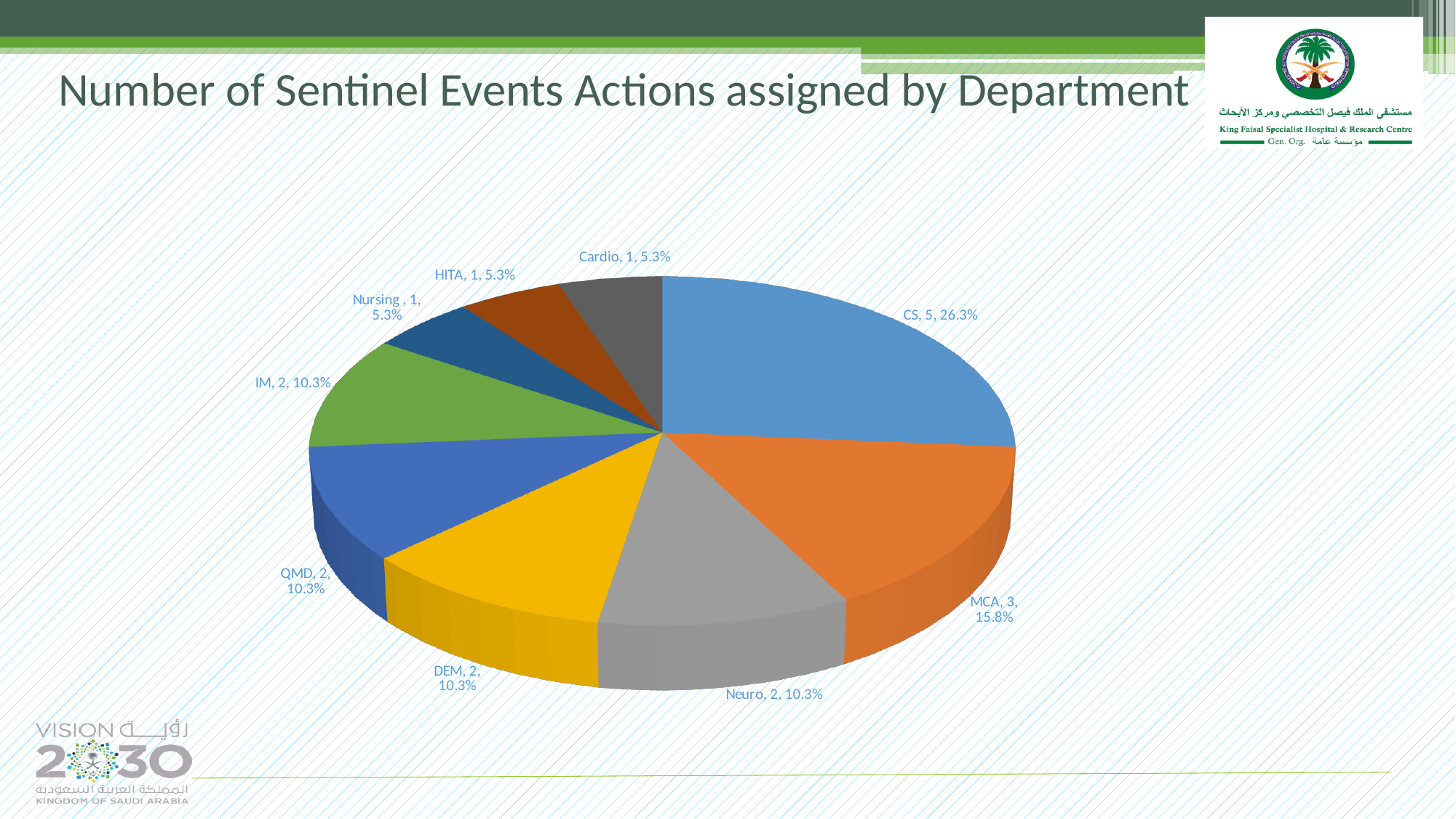
What is the total number of sentinel event actions across all departments in the pie chart? 19 Which department has the highest number of sentinel event actions? CS How many sentinel event actions are assigned to Cardio? 1 What is the title of the chart on the slide? Number of Sentinel Events Actions assigned by Department How many sentinel event actions are assigned to MCA? 3 Which has more sentinel event actions, MCA or IM? MCA How many sentinel event actions are assigned to CS? 5 How many departments (slices) are shown in the pie chart? 9 What percentage share of the pie does CS have? 26.3% What is the difference between the number of actions assigned to CS and MCA? 2 What kind of chart is shown on the slide? Pie chart What percentage share of the pie does Neuro have? 10.3%